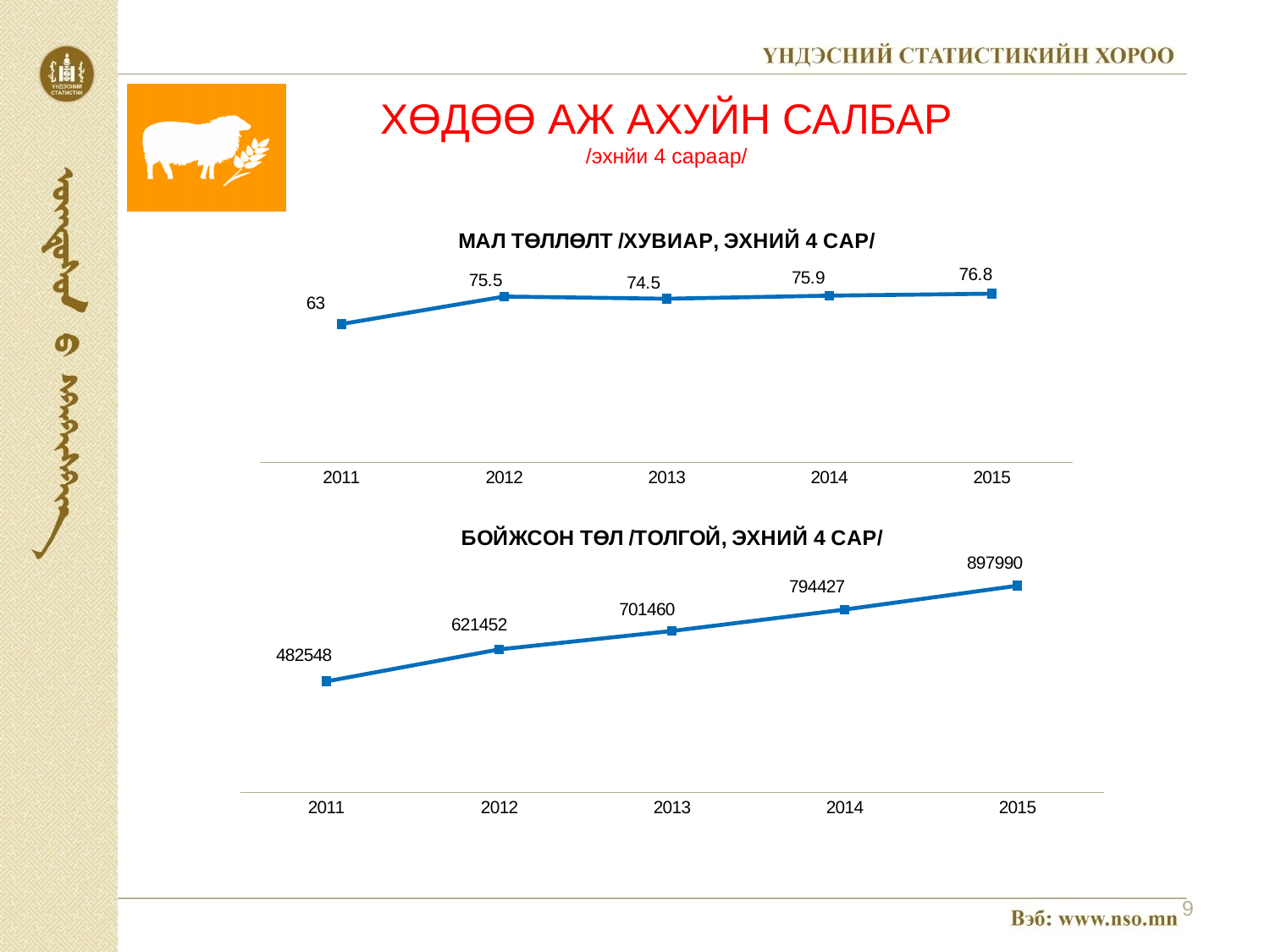
In the top chart (МАЛ ТӨЛЛӨЛТ /ХУВИАР, ЭХНИЙ 4 САР/), which year has the lowest value? 2011 In the bottom chart (БОЙЖСОН ТӨЛ /ТОЛГОЙ, ЭХНИЙ 4 САР/), what is the value for 2014? 794427 In the bottom chart (БОЙЖСОН ТӨЛ /ТОЛГОЙ, ЭХНИЙ 4 САР/), what is the value for 2011? 482548 In the top chart (МАЛ ТӨЛЛӨЛТ /ХУВИАР, ЭХНИЙ 4 САР/), what is the value for 2013? 74.5 In the top chart (МАЛ ТӨЛЛӨЛТ /ХУВИАР, ЭХНИЙ 4 САР/), what is the difference between the 2012 and 2011 values? 12.5 How many years are plotted in the bottom chart (БОЙЖСОН ТӨЛ /ТОЛГОЙ, ЭХНИЙ 4 САР/)? 5 In the top chart (МАЛ ТӨЛЛӨЛТ /ХУВИАР, ЭХНИЙ 4 САР/), which is larger, the value for 2012 or the value for 2013? 2012 In the bottom chart (БОЙЖСОН ТӨЛ /ТОЛГОЙ, ЭХНИЙ 4 САР/), what is the difference between the 2015 and 2014 values? 103563 What kind of chart is the top chart (МАЛ ТӨЛЛӨЛТ /ХУВИАР, ЭХНИЙ 4 САР/)? line chart In the top chart (МАЛ ТӨЛЛӨЛТ /ХУВИАР, ЭХНИЙ 4 САР/), what is the value for 2011? 63 In the top chart (МАЛ ТӨЛЛӨЛТ /ХУВИАР, ЭХНИЙ 4 САР/), which year has the highest value? 2015 In the bottom chart (БОЙЖСОН ТӨЛ /ТОЛГОЙ, ЭХНИЙ 4 САР/), do the values rise or fall from 2011 to 2015? rise